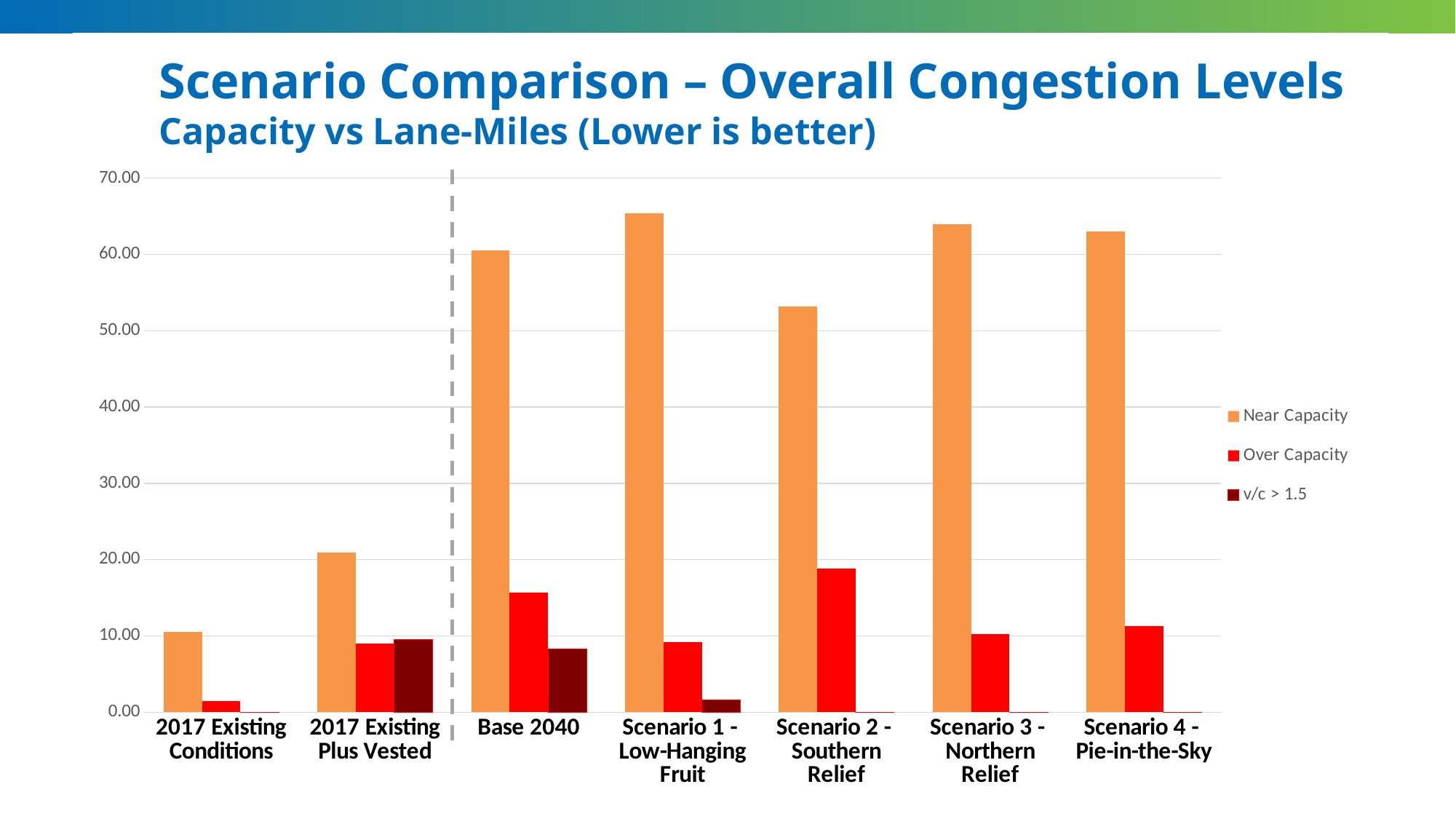
How many scenario categories are shown along the x axis? 7 Which has the larger Near Capacity value, Base 2040 or Scenario 2 - Southern Relief? Base 2040 Which category has the lowest Near Capacity value? 2017 Existing Conditions Is the Over Capacity value for Scenario 2 - Southern Relief greater or less than 10.00? greater Is the Near Capacity value for Scenario 2 - Southern Relief greater or less than 50.00? greater Which has the larger Over Capacity value, Base 2040 or Scenario 1 - Low-Hanging Fruit? Base 2040 What is the subtitle shown below the chart title? Capacity vs Lane-Miles (Lower is better) Which category has the highest Over Capacity value? Scenario 2 - Southern Relief How many series does the legend list? 3 What kind of chart is shown on the slide? bar chart Is the Near Capacity value for 2017 Existing Plus Vested greater or less than 30.00? less